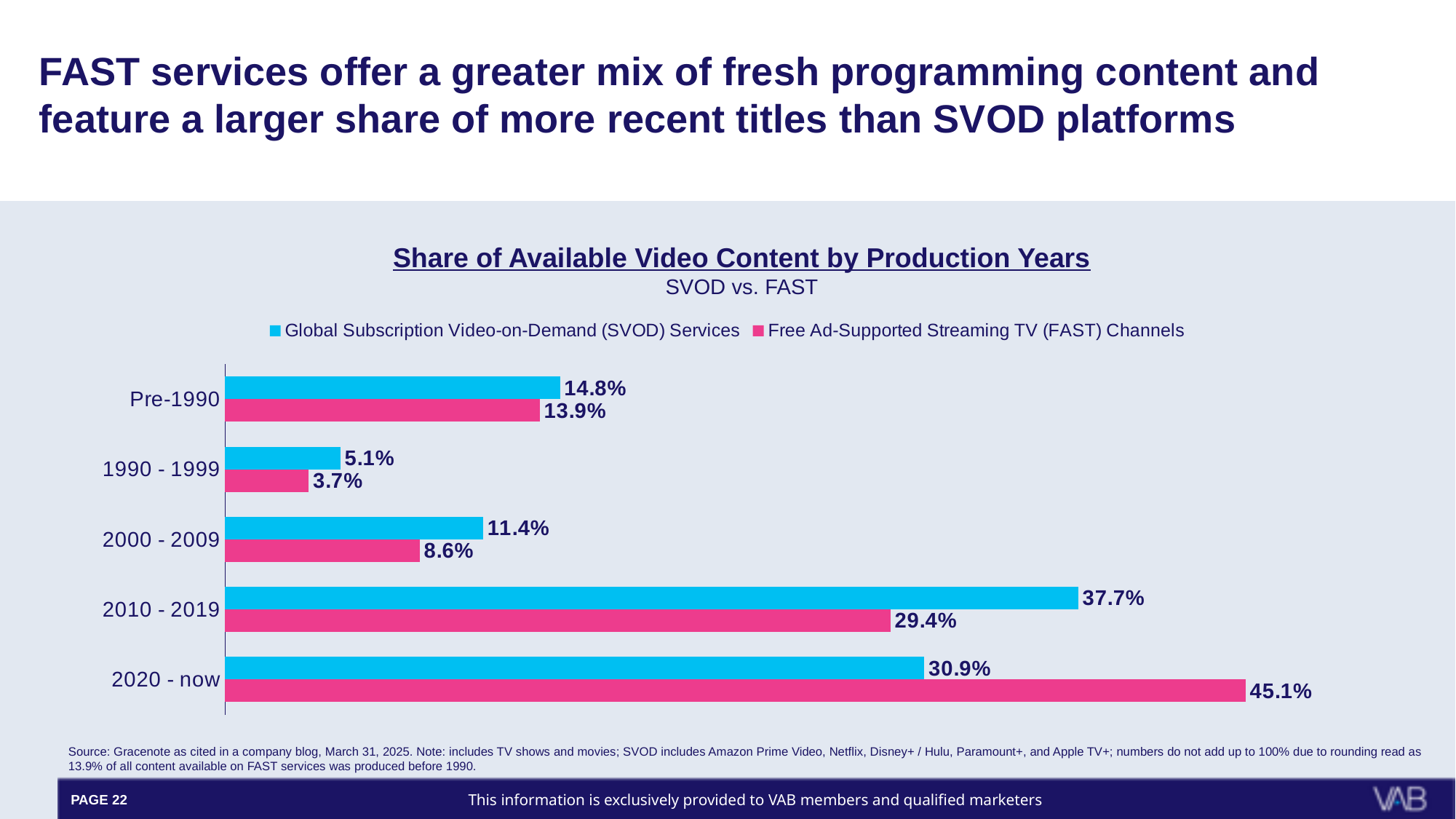
What is the difference between the FAST and SVOD shares for 2020 - now? 14.2% For the Pre-1990 category, which is larger: the SVOD share or the FAST share? SVOD What is the FAST share for the 1990 - 1999 production years? 3.7% What is the FAST share of available video content for the 2020 - now production years? 45.1% What is the difference between the SVOD and FAST shares for 2000 - 2009? 2.8% What is the SVOD share of available video content for the 2010 - 2019 production years? 37.7% What kind of chart is shown on the slide? Bar chart Which production-year category has the lowest SVOD share? 1990 - 1999 Which production-year category has the highest FAST share? 2020 - now What colour are the bars for the Free Ad-Supported Streaming TV (FAST) Channels series? Pink How many series does the legend list? 2 How many production-year categories are shown on the chart? 5